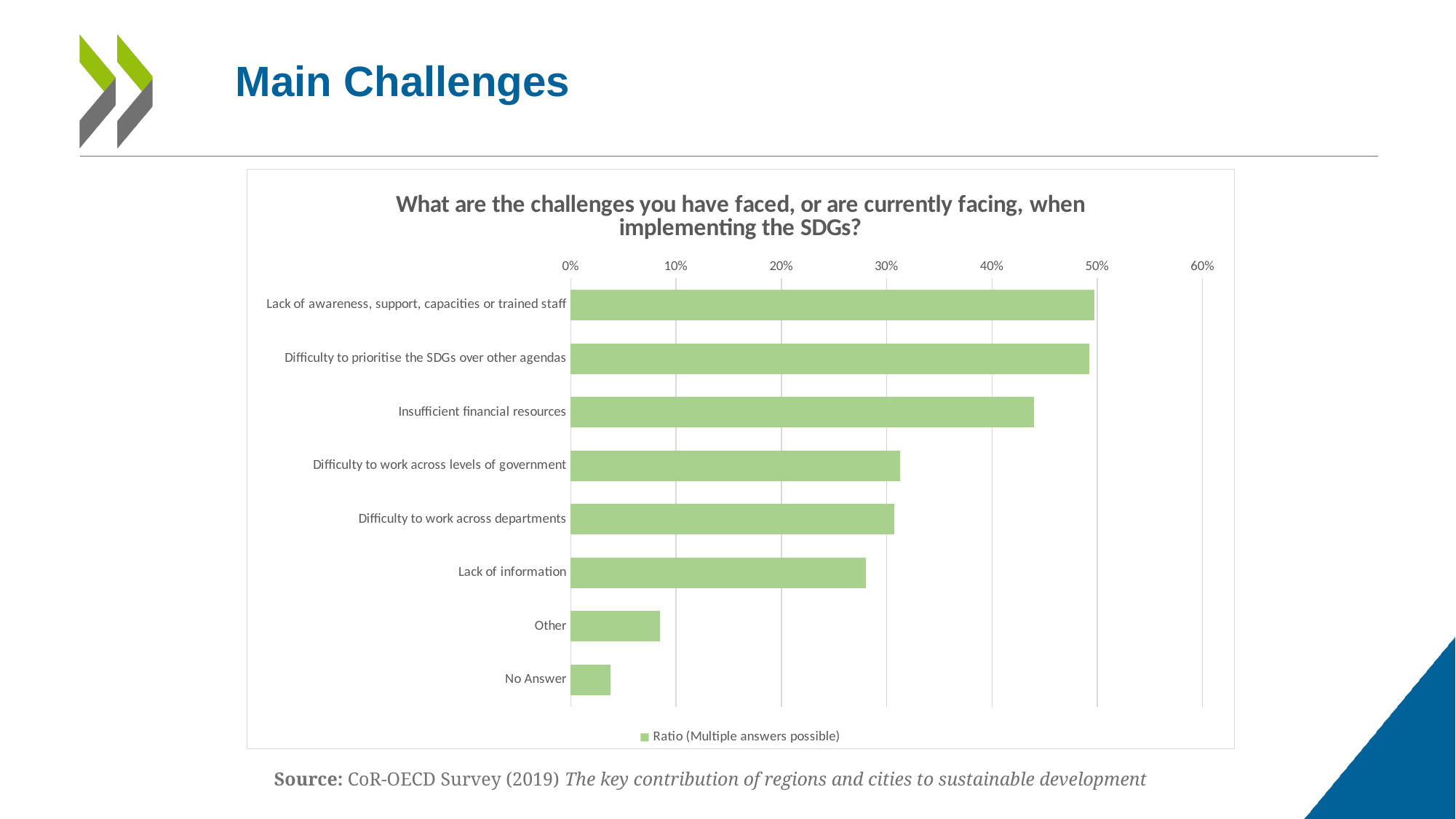
Which is larger: the value for Insufficient financial resources or the value for Lack of information? Insufficient financial resources Is the value for Insufficient financial resources greater or less than 40%? greater Is the value for Other greater or less than 10%? less Is the value for Lack of information greater or less than 30%? less What kind of chart is shown on the slide? bar chart Which is larger: the value for Other or the value for No Answer? Other How many challenge categories are plotted in the chart? 8 Which category has the lowest value in the chart? No Answer What is the legend entry shown below the chart? Ratio (Multiple answers possible) What is the title of the chart? What are the challenges you have faced, or are currently facing, when implementing the SDGs? How many series does the legend list? 1